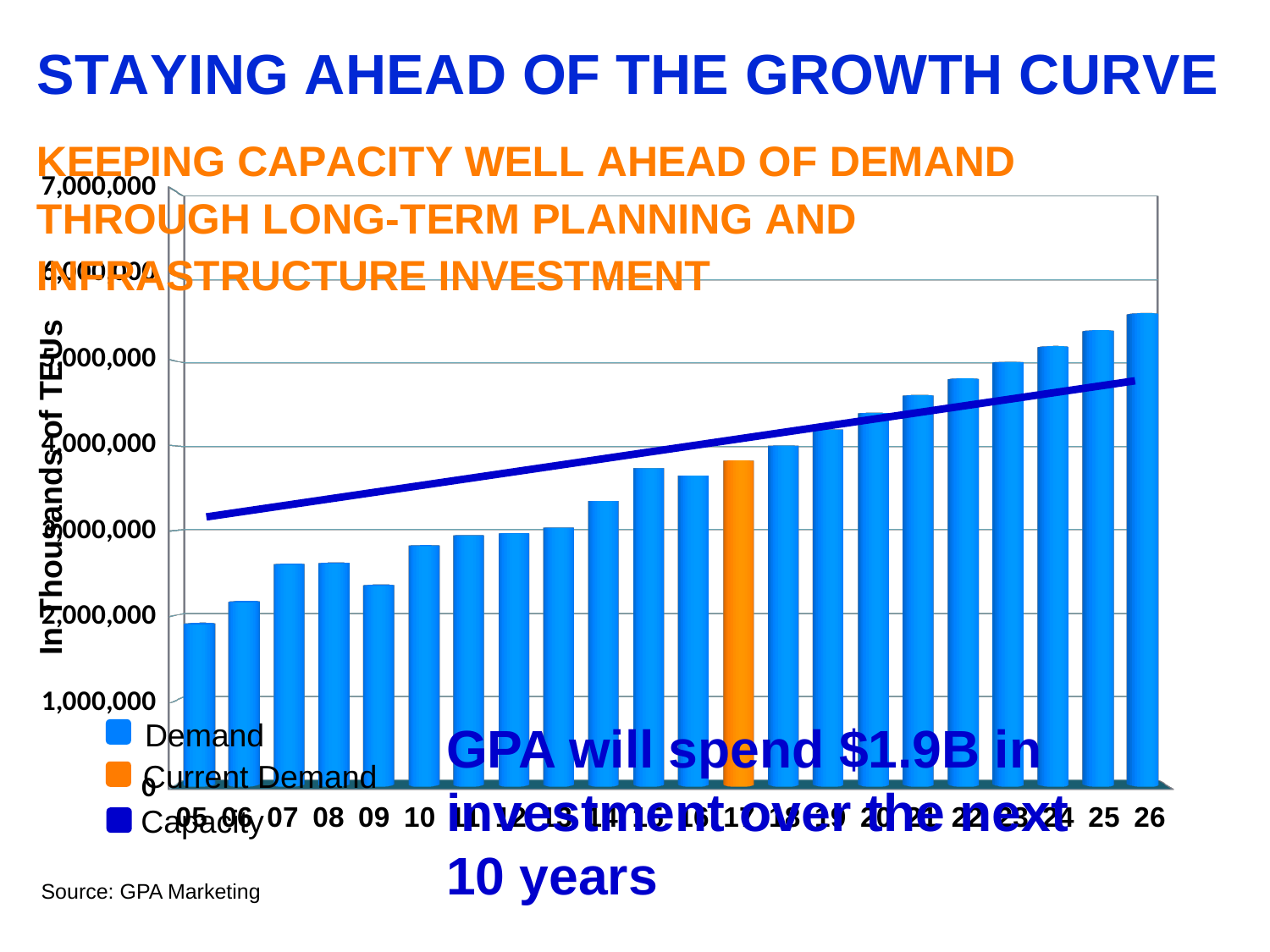
Which bar is taller, 07 or 09? 07 What is the label on the vertical axis? In Thousands of TEUs Which year has the shortest bar? 05 Is the value for 26 greater or less than 5,000,000? greater Is the value for 05 greater or less than 2,000,000? less What kind of chart is shown on the slide? bar chart Is the Current Demand bar for 17 greater or less than 4,000,000? less How many series does the legend list? 3 Which year is shown with an orange bar? 17 Which year has the tallest Demand bar? 26 Do the Demand bars generally rise or fall from 05 to 26? rise